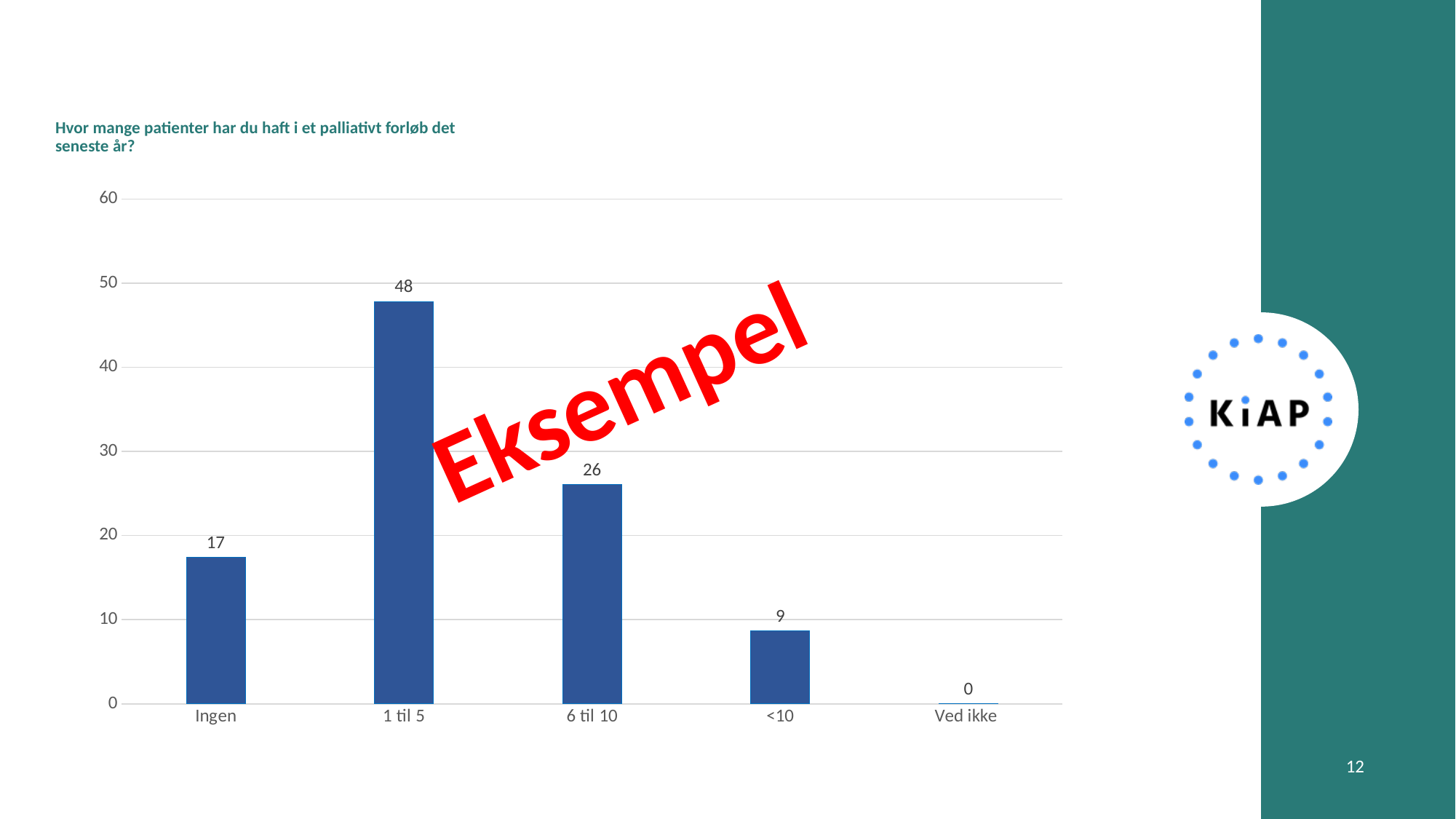
Is the value for "6 til 10" greater or less than 30? less What is the value for the category "Ingen"? 17 What is the value for the category "Ved ikke"? 0 What is the difference between the values for "1 til 5" and "6 til 10"? 22 What is the title of the chart? Hvor mange patienter har du haft i et palliativt forløb det seneste år? Which is larger, the value for "Ingen" or the value for "<10"? Ingen Which category has the highest value? 1 til 5 Which category has the lowest value? Ved ikke How many categories are shown on the x axis? 5 What is the value for the category "1 til 5"? 48 What kind of chart is shown on the slide? bar chart What is the value for the category "6 til 10"? 26